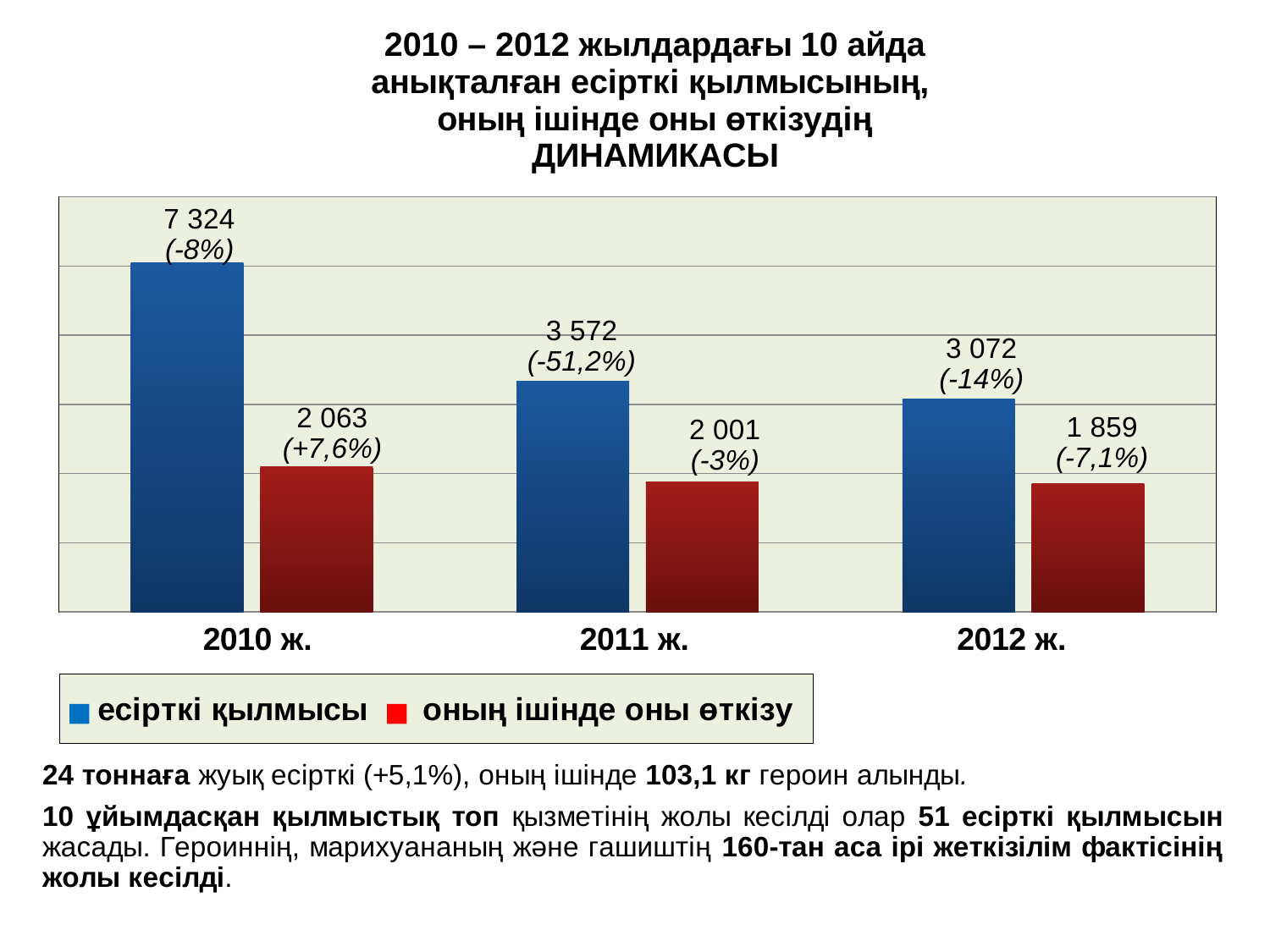
What is the value for есірткі қылмысы in 2011 ж.? 3 572 How many series does the legend list? 2 In which year is the оның ішінде оны өткізу value lowest? 2012 ж. What is the value for есірткі қылмысы in 2010 ж.? 7 324 Does the есірткі қылмысы value rise or fall from 2010 ж. to 2012 ж.? fall Which is larger in 2012 ж.: есірткі қылмысы or оның ішінде оны өткізу? есірткі қылмысы How many years are shown on the x axis? 3 What is the value for оның ішінде оны өткізу in 2012 ж.? 1 859 What is the difference between the есірткі қылмысы values for 2010 ж. and 2011 ж.? 3 752 What kind of chart is shown on the slide? bar chart In which year is the есірткі қылмысы value highest? 2010 ж. What percentage change is shown next to the есірткі қылмысы value for 2011 ж.? -51,2%